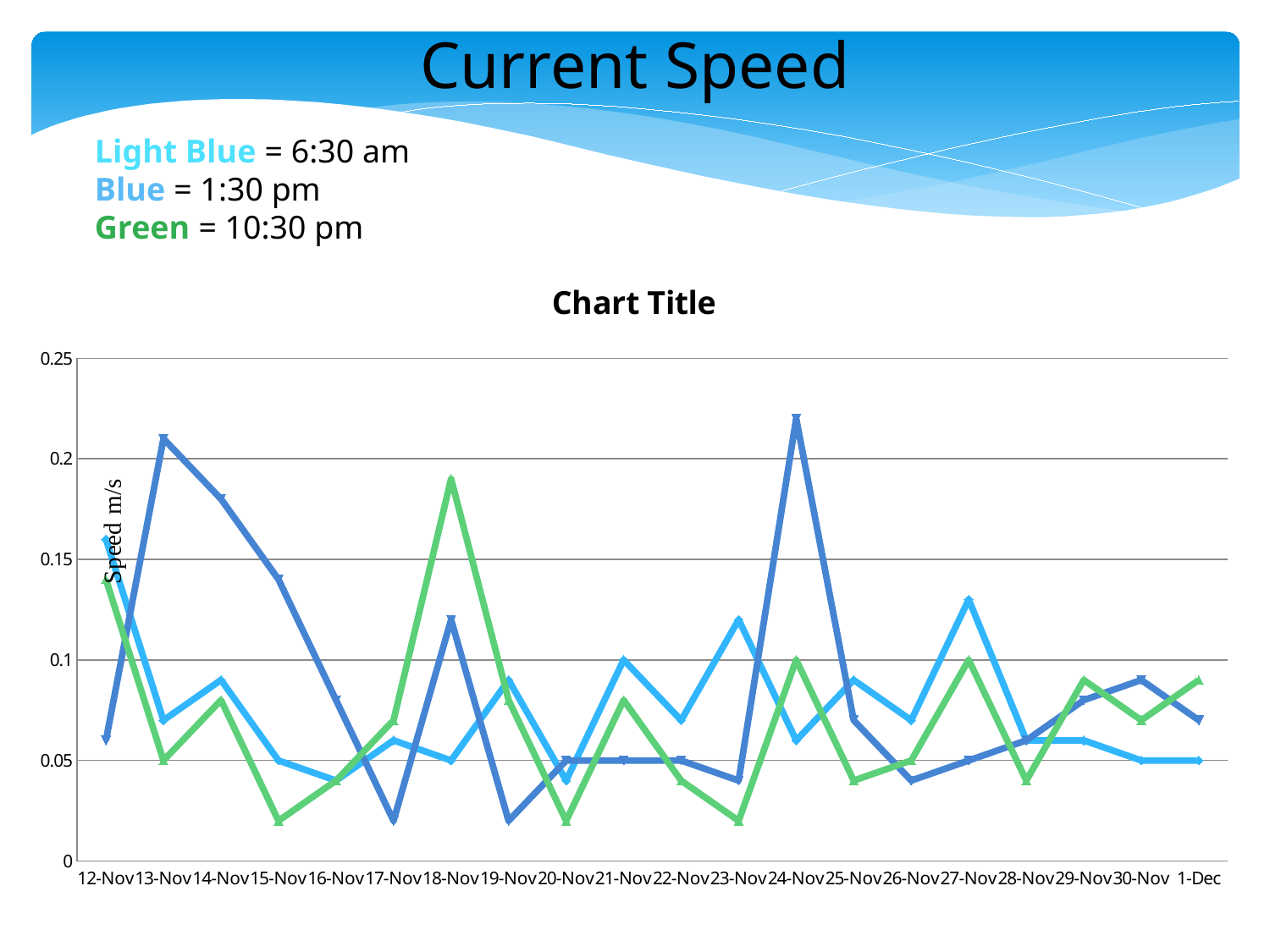
On which date does the green (10:30 pm) line reach its highest value? 18-Nov Is the value of the green (10:30 pm) line on 18-Nov greater or less than 0.15? greater Is the value of the blue (1:30 pm) line on 24-Nov greater or less than 0.2? greater What is the label on the vertical axis of the chart? Speed m/s What kind of chart is shown on the slide? line chart How many dates are shown along the x axis of the chart? 20 Is the value of the blue (1:30 pm) line on 12-Nov greater or less than 0.1? less On 18-Nov, which line has the higher value, the green (10:30 pm) line or the blue (1:30 pm) line? green (10:30 pm) Does the blue (1:30 pm) line rise or fall from 13-Nov to 17-Nov? fall On which date does the light blue (6:30 am) line reach its highest value? 12-Nov According to the slide text, what time of day does the green line represent? 10:30 pm How many lines (series) are plotted on the chart? 3